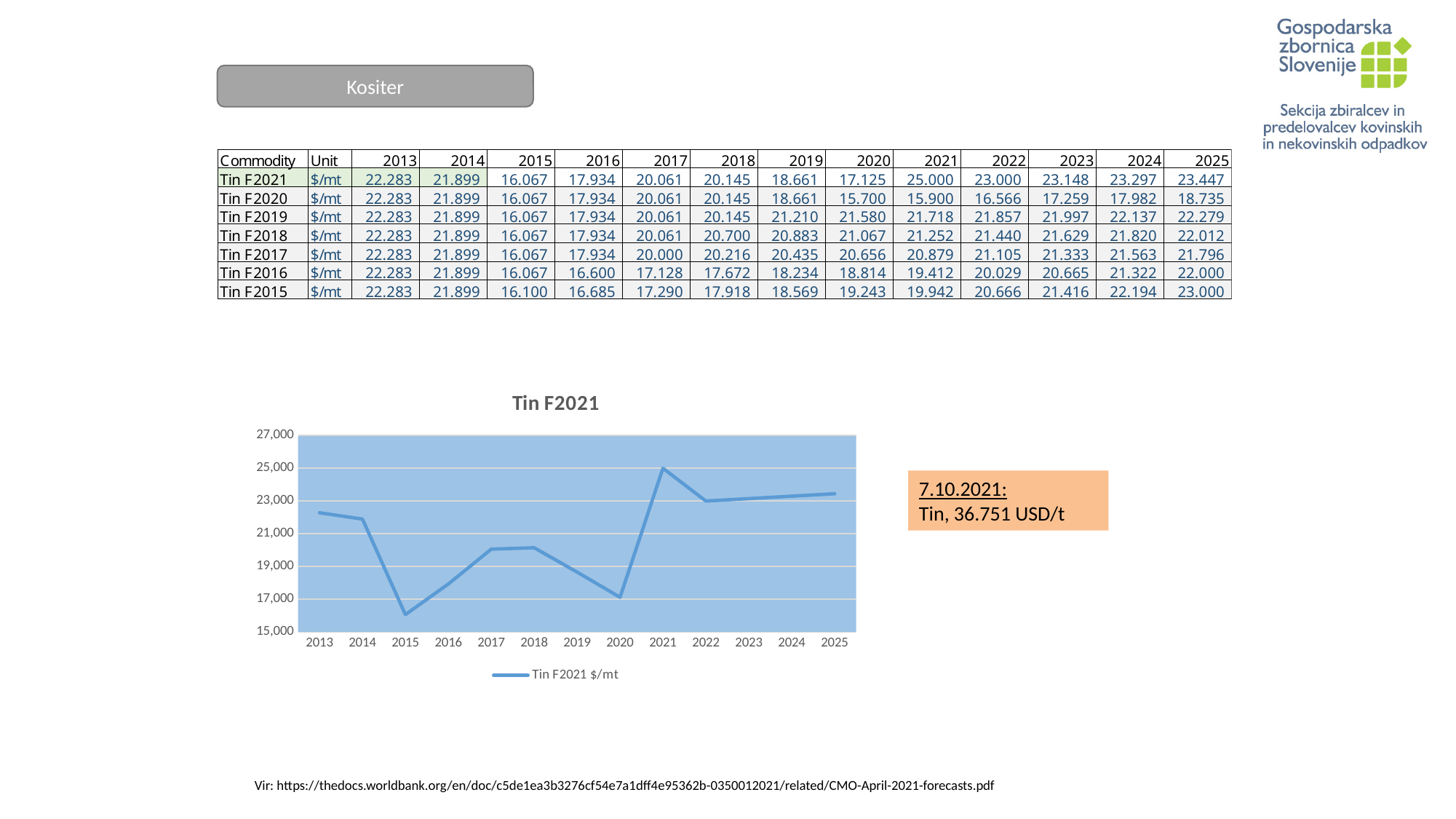
Using the table values, what is the difference between the Tin F2021 values for 2021 and 2020? 7.875 In the Tin F2021 chart, which year has the larger value, 2017 or 2020? 2017 What is the legend entry shown below the Tin F2021 chart? Tin F2021 $/mt In the Tin F2021 chart, does the line rise or fall between 2018 and 2020? fall How many series does the legend of the Tin F2021 chart list? 1 In which year does the Tin F2021 line reach its lowest value? 2015 What kind of chart is shown under the title "Tin F2021"? line chart In the Tin F2021 chart, is the value for 2022 greater or less than 21,000? greater In the Tin F2021 chart, is the value for 2020 greater or less than 19,000? less In which year does the Tin F2021 line reach its highest value? 2021 According to the table, what is the Tin F2021 value for 2021? 25.000 How many years are plotted along the x axis of the Tin F2021 chart? 13